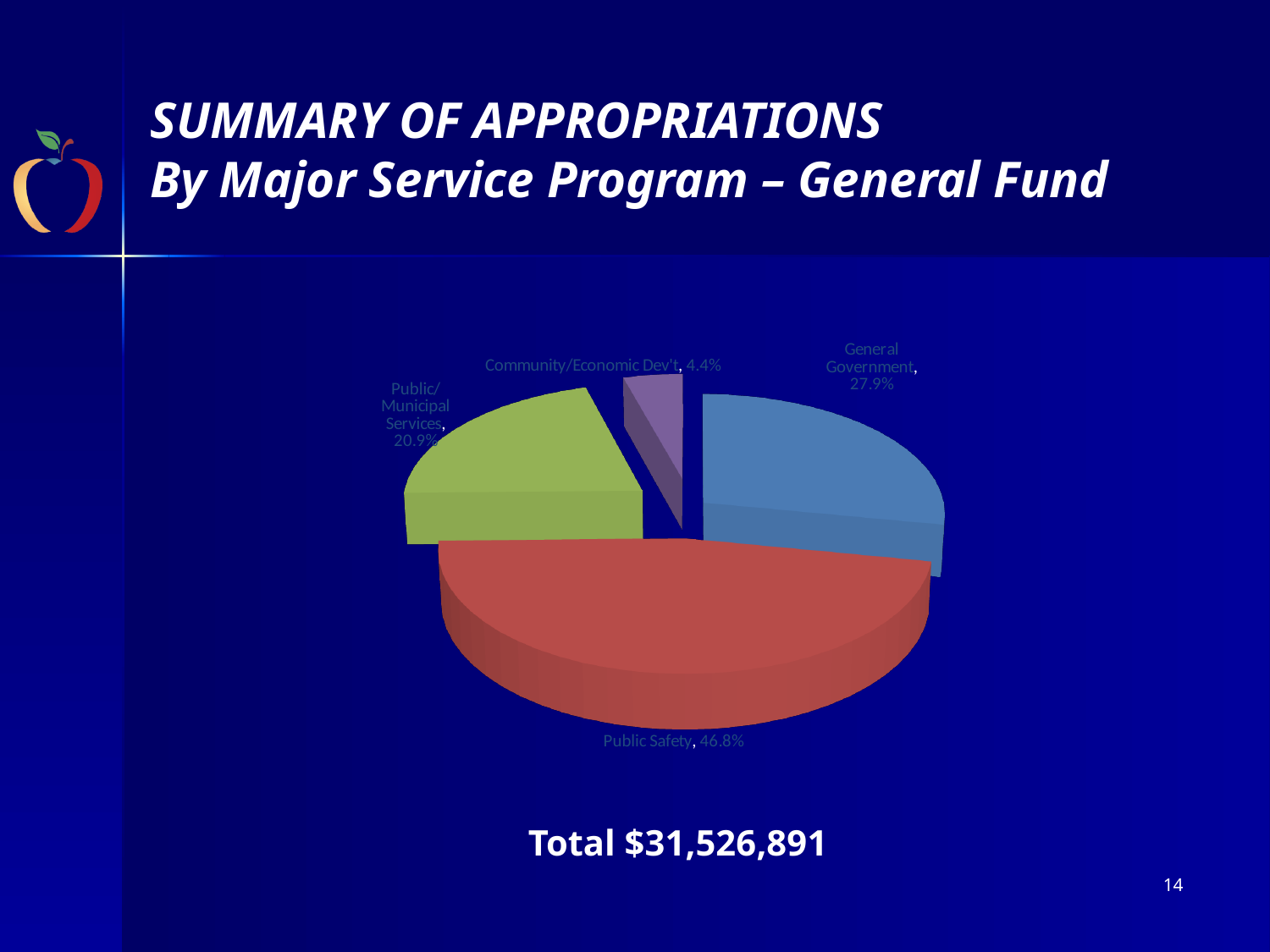
What kind of chart is shown on the slide? Pie chart Which category has the largest slice of the pie? Public Safety What share of the pie does Public/Municipal Services represent? 20.9% Which is larger, the General Government slice or the Public/Municipal Services slice? General Government What share of the pie does Public Safety represent? 46.8% What total amount is stated below the chart? $31,526,891 What share of the pie does General Government represent? 27.9% What colour is the Public Safety slice? Red What share of the pie does Community/Economic Dev't represent? 4.4% What is the difference in percentage points between Public Safety and General Government? 18.9 How many categories are shown in the pie chart? 4 Which category has the smallest slice of the pie? Community/Economic Dev't